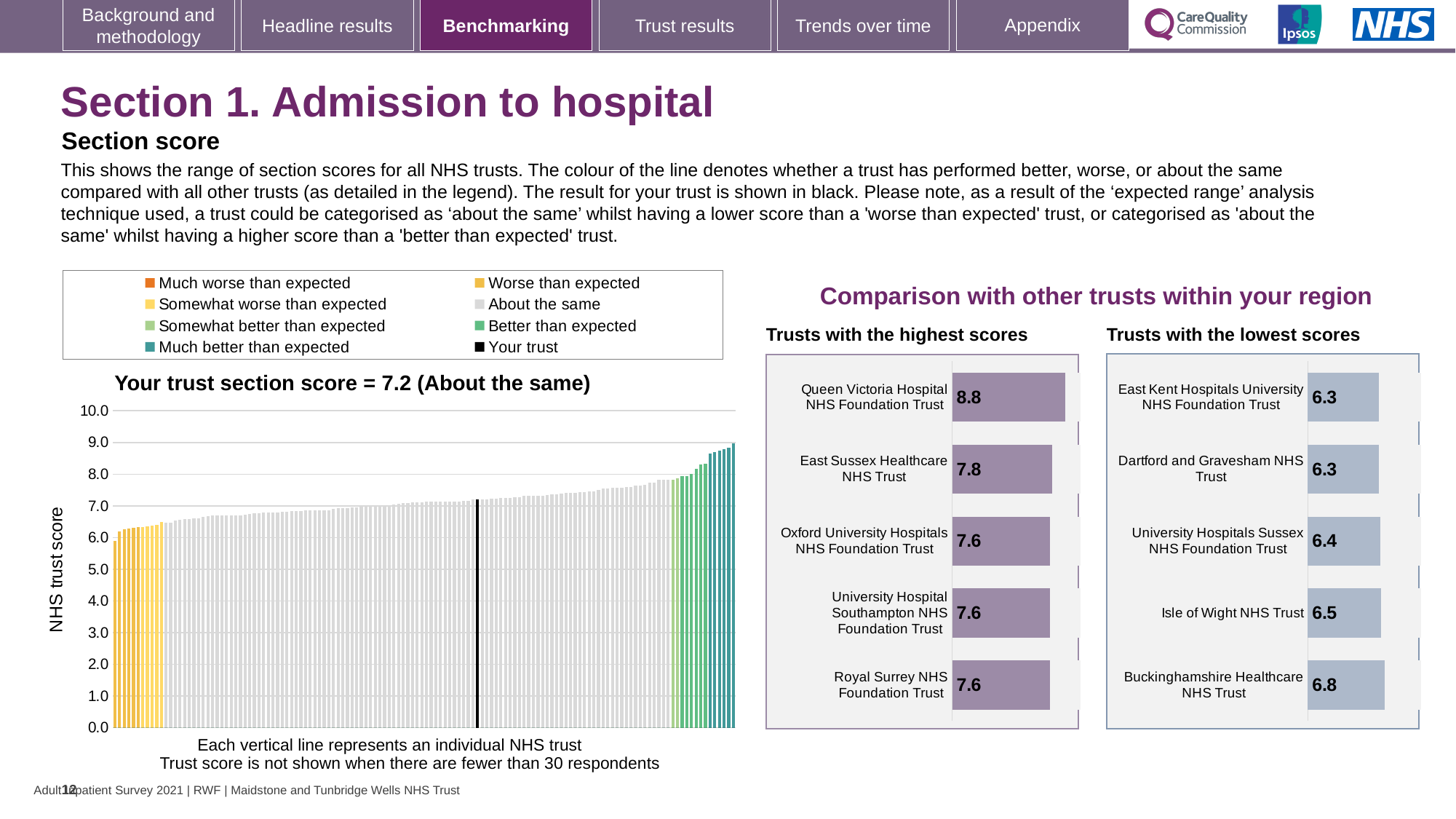
In the 'Trusts with the highest scores' chart, what is the difference between the scores of Queen Victoria Hospital NHS Foundation Trust and East Sussex Healthcare NHS Trust? 1.0 In the 'Trusts with the highest scores' chart, which trust has the highest score? Queen Victoria Hospital NHS Foundation Trust In the 'Trusts with the highest scores' chart, what is the score for Royal Surrey NHS Foundation Trust? 7.6 According to the title of the chart on the left, what is your trust's section score? 7.2 In the 'Trusts with the lowest scores' chart, what is the difference between the scores of Buckinghamshire Healthcare NHS Trust and East Kent Hospitals University NHS Foundation Trust? 0.5 In the 'Trusts with the highest scores' chart, which has the larger score: East Sussex Healthcare NHS Trust or Oxford University Hospitals NHS Foundation Trust? East Sussex Healthcare NHS Trust In the 'Trusts with the highest scores' chart, what is the score for Queen Victoria Hospital NHS Foundation Trust? 8.8 What kind of chart is the 'Your trust section score' chart on the left? Bar chart How many entries does the legend above the 'Your trust section score' chart list? 8 How many trusts are shown in the 'Trusts with the highest scores' chart? 5 In the 'Trusts with the lowest scores' chart, which trust has the highest score? Buckinghamshire Healthcare NHS Trust In the 'Trusts with the lowest scores' chart, what is the score for Isle of Wight NHS Trust? 6.5